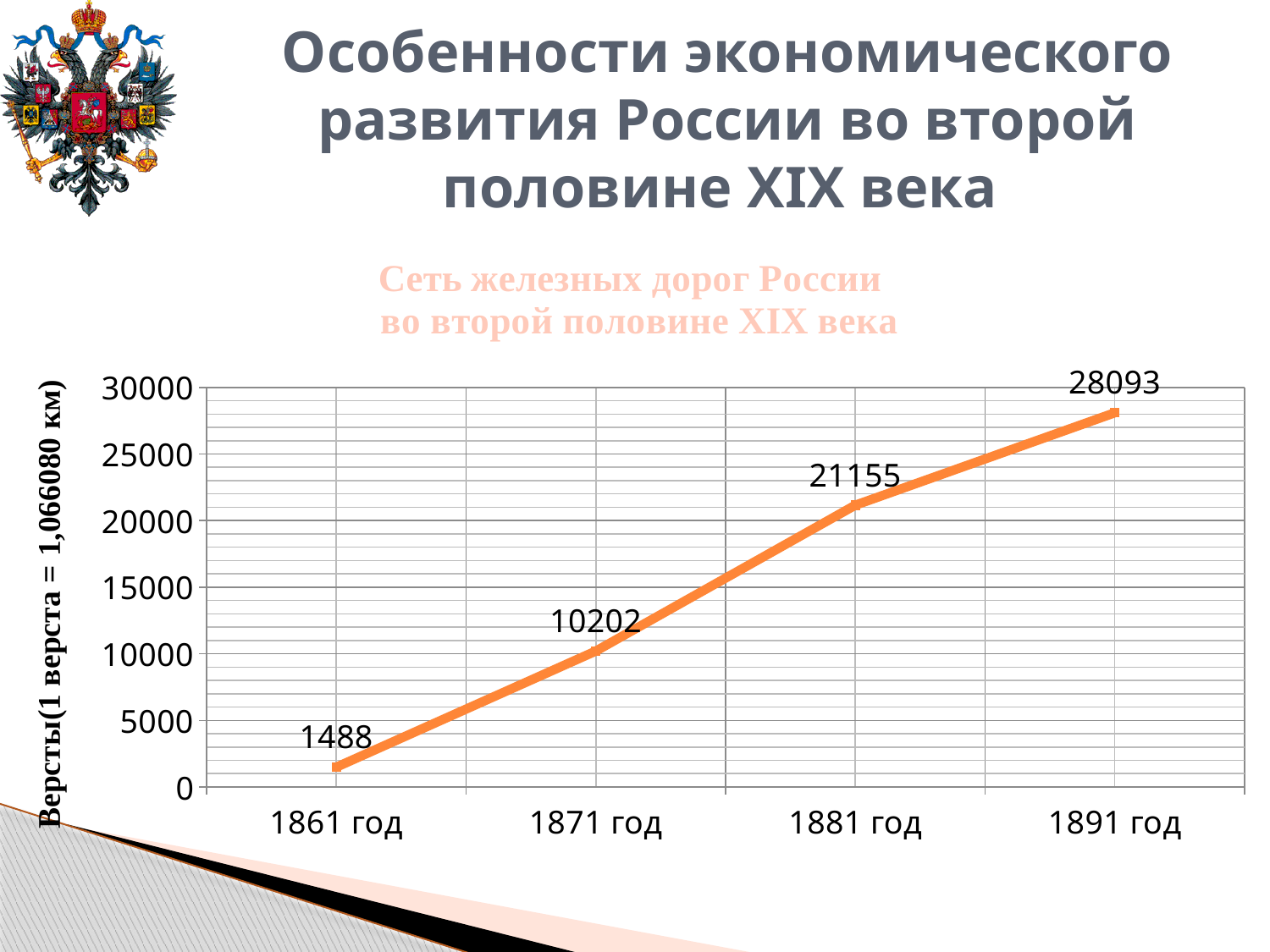
What is the value for 1881 год? 21155 What kind of chart is shown on the slide? line chart Which is larger, the value for 1871 год or the value for 1881 год? 1881 год What is the value for 1871 год? 10202 Which year has the lowest value? 1861 год How many data points are plotted on the chart? 4 What is the difference between the values for 1891 год and 1881 год? 6938 Do the values rise or fall from 1861 год to 1891 год? rise What is the value for 1891 год? 28093 What is the value for 1861 год? 1488 What is the difference between the values for 1871 год and 1861 год? 8714 Which year has the highest value? 1891 год